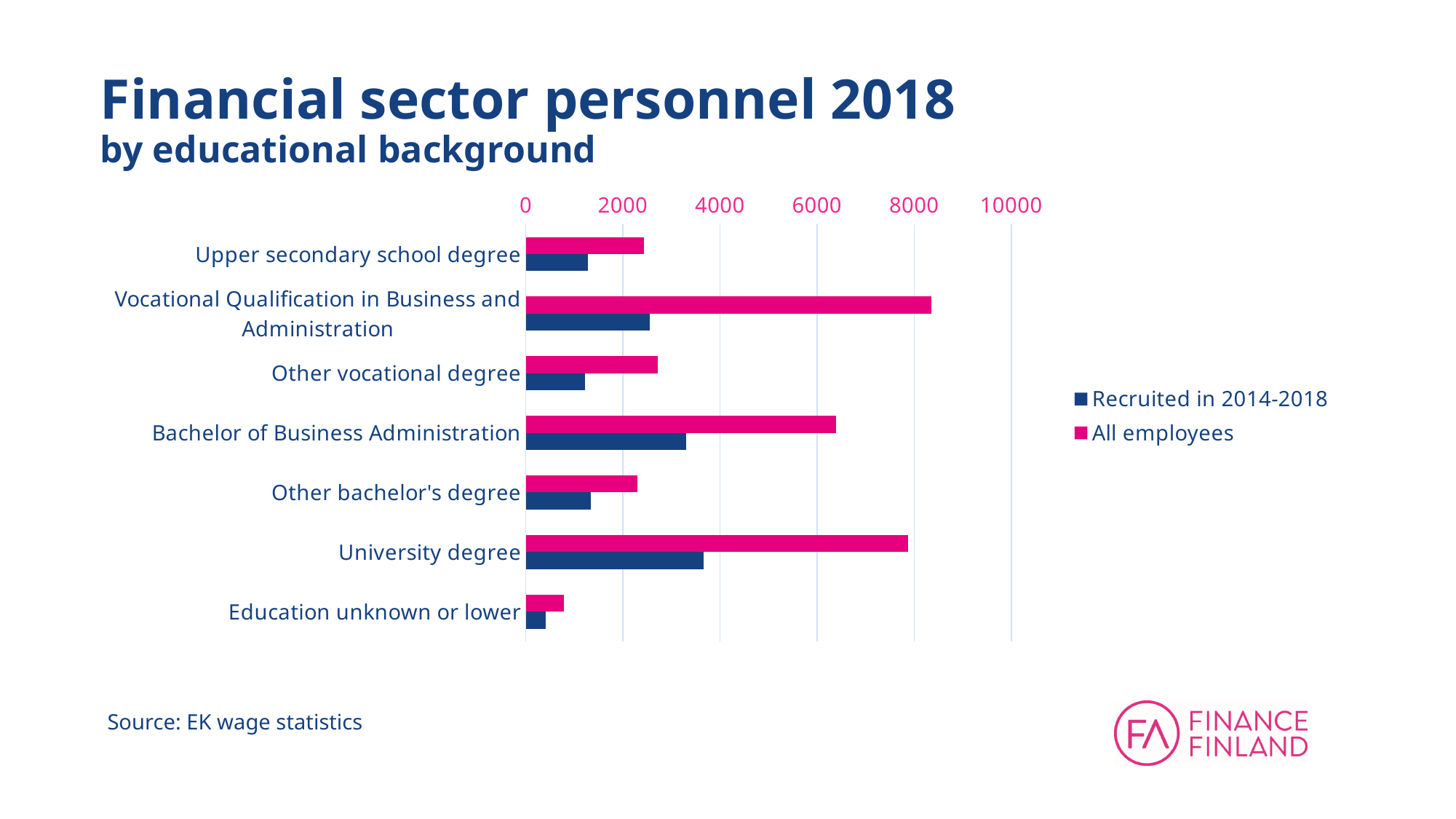
Is the Recruited in 2014-2018 value for University degree greater or less than 2000? greater For All employees, which is larger: Bachelor of Business Administration or University degree? University degree Which educational background has the highest value for Recruited in 2014-2018? University degree Which educational background has the highest value for All employees? Vocational Qualification in Business and Administration What kind of chart is shown on the slide? Bar chart Which educational background has the lowest value for All employees? Education unknown or lower Is the All employees value for University degree greater or less than 8000? less Is the All employees value for Education unknown or lower greater or less than 1000? less How many educational background categories are shown in the chart? 7 What is the source cited for the chart data? EK wage statistics How many series does the legend list? 2